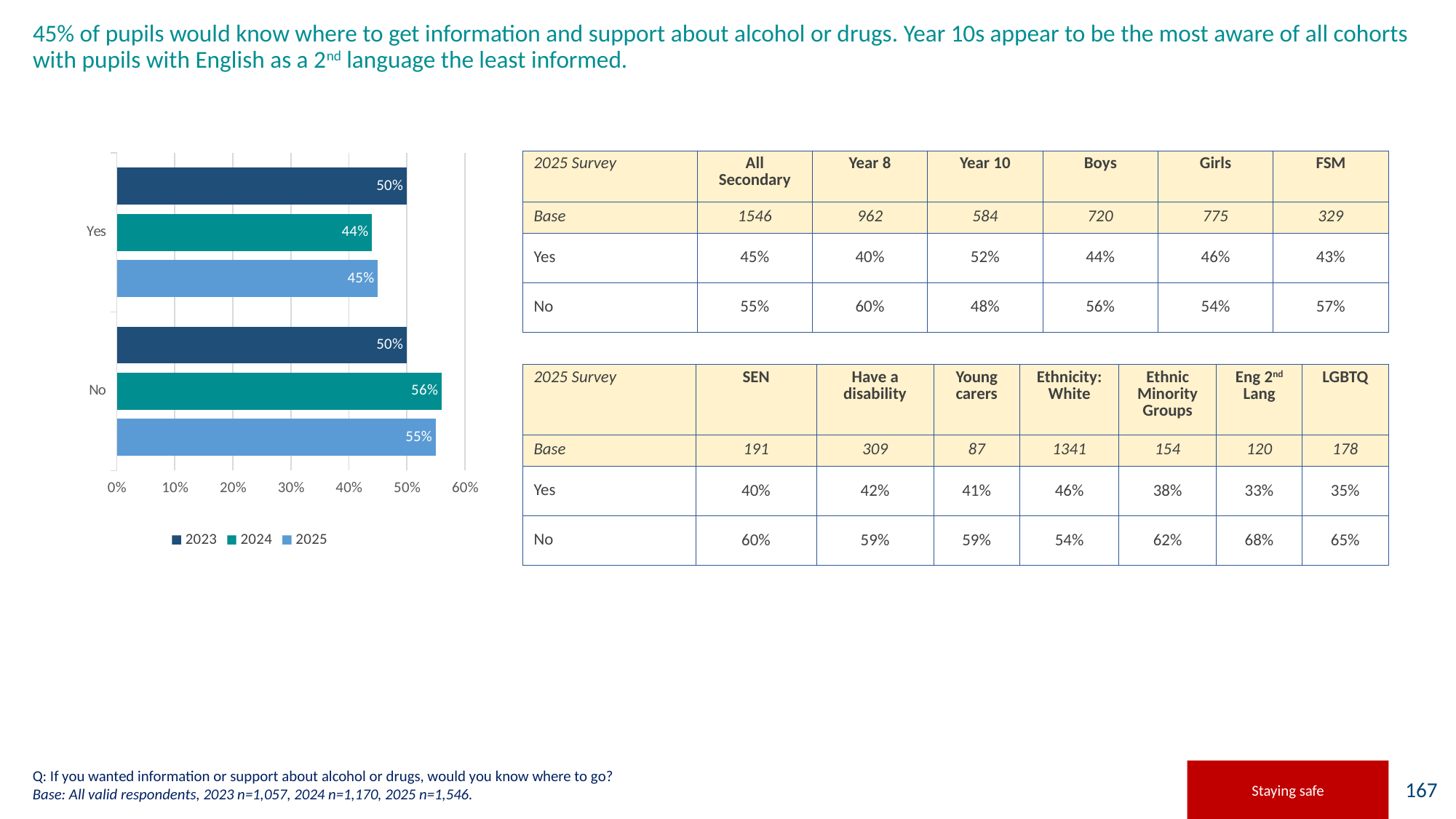
What kind of chart is shown on the slide? bar chart Which year has the lowest value for 'Yes'? 2024 Which year has the highest value for 'No'? 2024 What is the value for 'No' in 2025? 55% What is the difference between the 'No' value in 2024 and the 'Yes' value in 2024? 12% How many series does the chart legend list? 3 How many categories are shown on the chart's vertical axis? 2 What is the value for 'Yes' in 2025? 45% Which is larger: the 'Yes' value in 2023 or the 'Yes' value in 2025? 2023 What is the value for 'Yes' in 2023? 50% What is the value for 'No' in 2024? 56% Which series is shown in the darkest blue colour in the chart legend? 2023